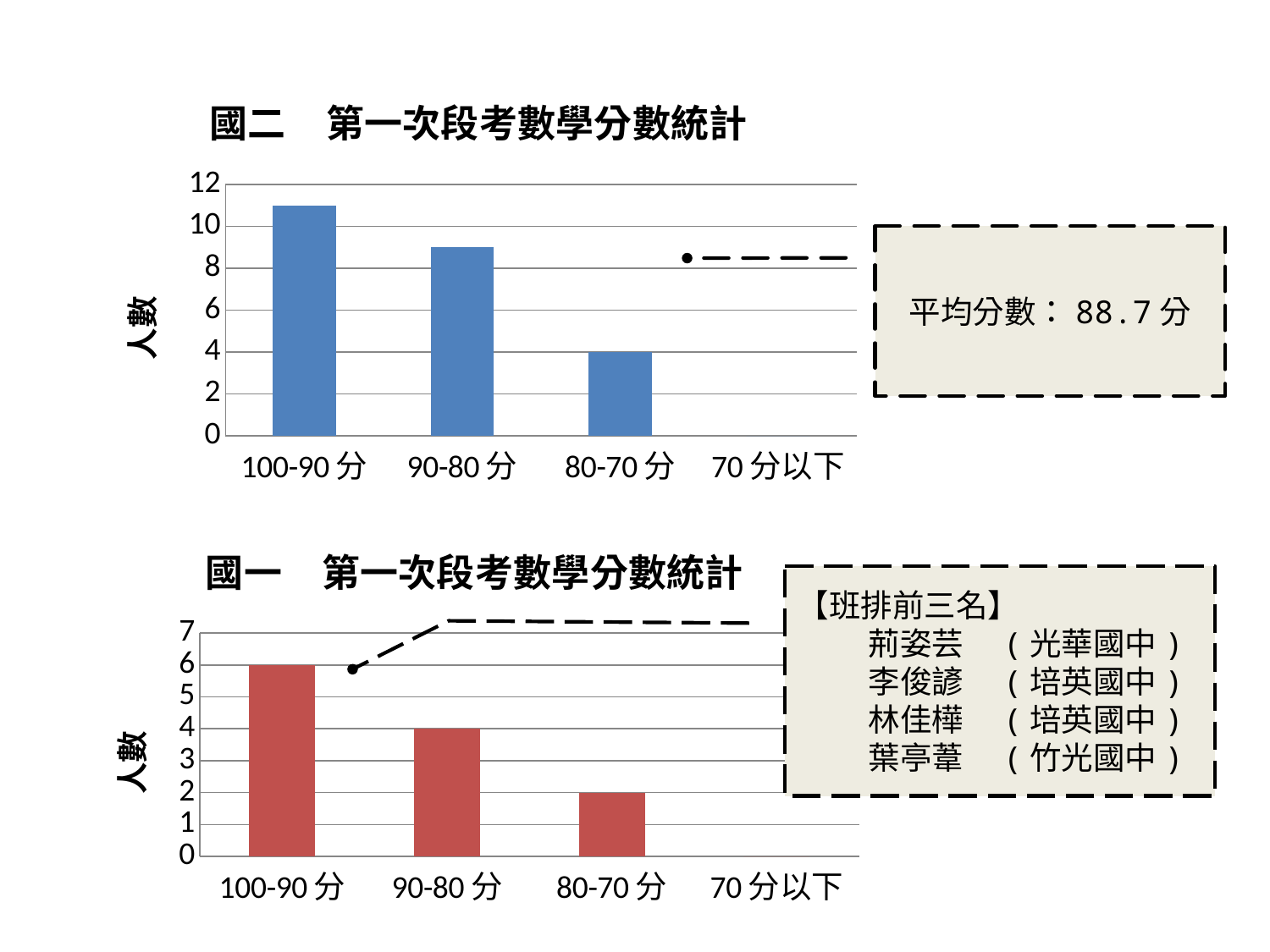
In the bottom chart (國一 第一次段考數學分數統計), what is the value for 80-70分? 2 In the bottom chart (國一 第一次段考數學分數統計), do the values rise or fall from left to right along the x axis? fall In the bottom chart (國一 第一次段考數學分數統計), which is larger, the value for 90-80分 or the value for 80-70分? 90-80分 In the bottom chart (國一 第一次段考數學分數統計), what is the value for 100-90分? 6 In the top chart (國二 第一次段考數學分數統計), what is the value for 80-70分? 4 How many categories are shown on the x axis of the top chart (國二 第一次段考數學分數統計)? 4 In the bottom chart (國一 第一次段考數學分數統計), what is the difference between the values for 100-90分 and 90-80分? 2 In the top chart (國二 第一次段考數學分數統計), is the value for 100-90分 greater or less than 10? greater In the top chart (國二 第一次段考數學分數統計), is the value for 90-80分 greater or less than 8? greater What kind of chart is the bottom chart (國一 第一次段考數學分數統計)? bar chart In the top chart (國二 第一次段考數學分數統計), which category has the highest value? 100-90分 In the bottom chart (國一 第一次段考數學分數統計), what is the value for 90-80分? 4